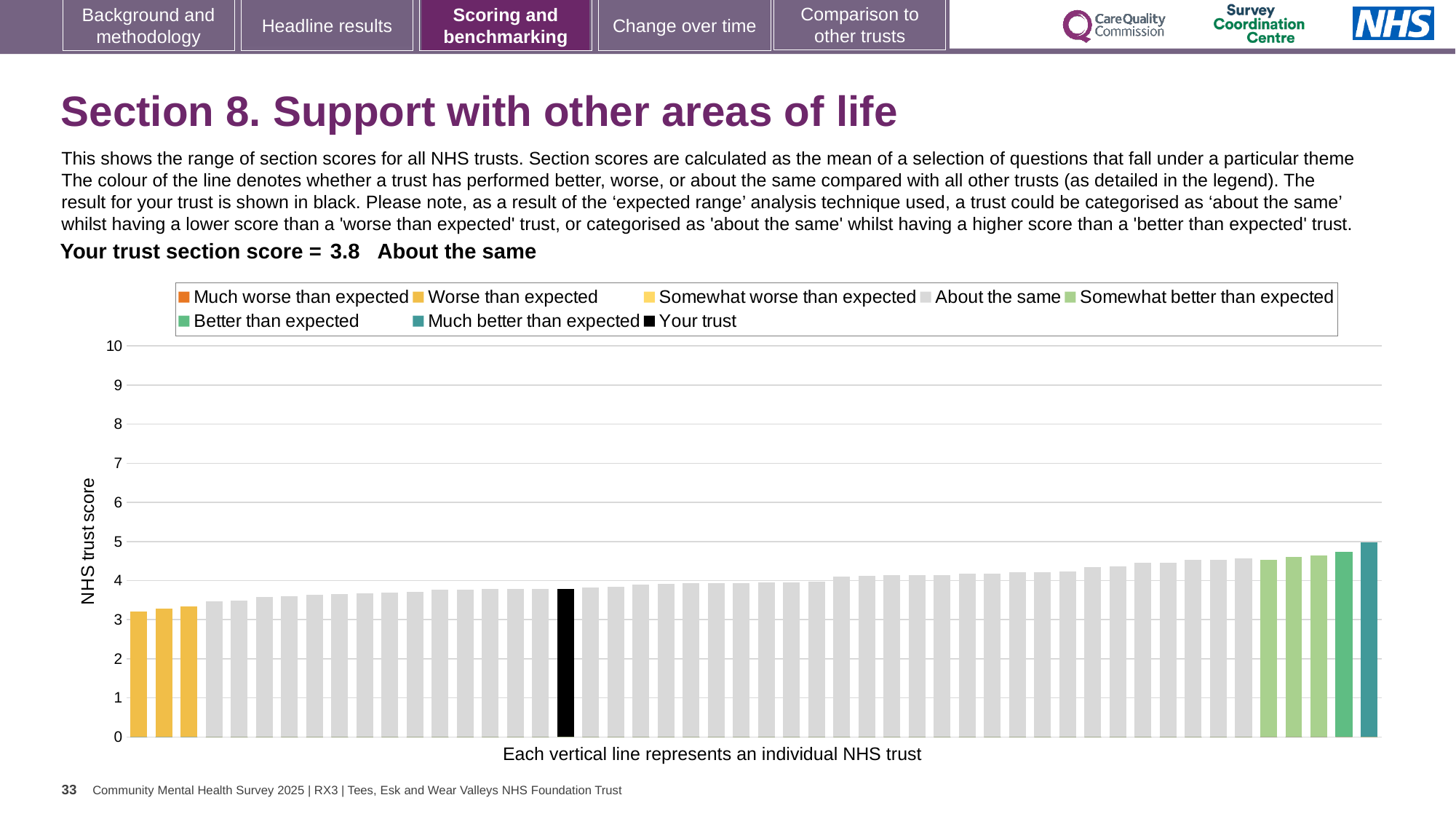
Is the value for the lowest-scoring trust greater or less than 4? less Is the value for the highest-scoring trust greater or less than 4? greater What is the label of the y axis? NHS trust score Is the value for your trust greater or less than 4? less What kind of chart is shown on the slide? bar chart Do the bar values rise or fall from left to right along the x axis? rise What is the section score for your trust? 3.8 Which category is your trust's section score placed in? About the same How many trusts are shown in the 'Worse than expected' colour? 3 How many entries does the legend list? 8